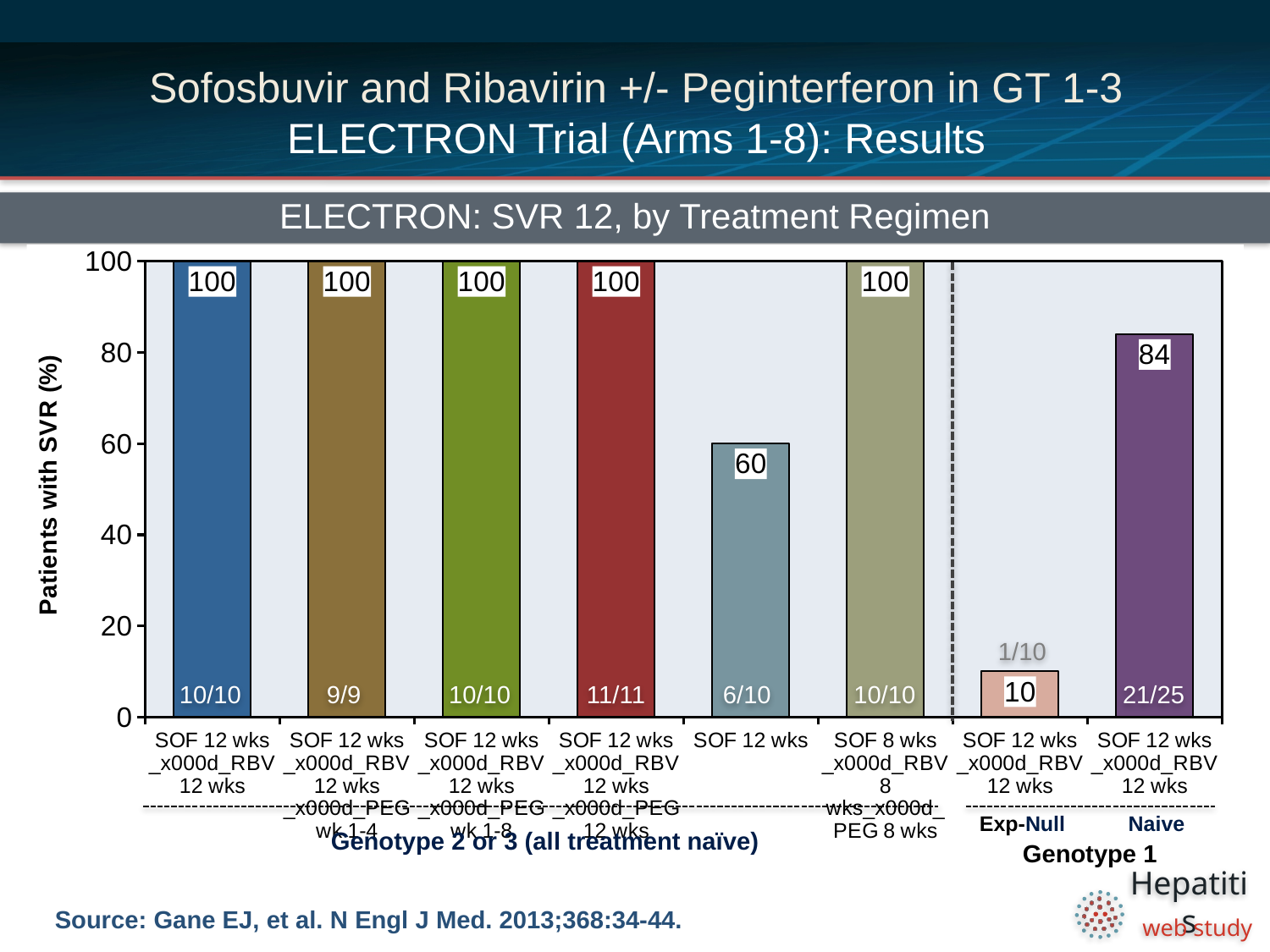
What kind of chart is shown on the slide? Bar chart How many treatment arms reached an SVR 12 of 100? 5 What is the label of the y-axis? Patients with SVR (%) What is the difference in SVR 12 between the SOF 8 wks arm and the SOF 12 wks monotherapy arm? 40 Which treatment arm has the lowest SVR 12 value? Genotype 1 Exp-Null (SOF 12 wks + RBV 12 wks) How many treatment arms (bars) are shown in the chart? 8 What is the SVR 12 value for the Genotype 1 Naive arm? 84 Which has a higher SVR 12: the SOF 12 wks monotherapy arm or the Genotype 1 Naive arm? Genotype 1 Naive What is the SVR 12 value for the SOF 12 wks monotherapy arm (fifth bar)? 60 What patient fraction is shown for the SOF 12 wks monotherapy arm? 6/10 What is the difference in SVR 12 between the Genotype 1 Naive arm and the Genotype 1 Exp-Null arm? 74 What is the SVR 12 value for the Genotype 1 Exp-Null arm? 10